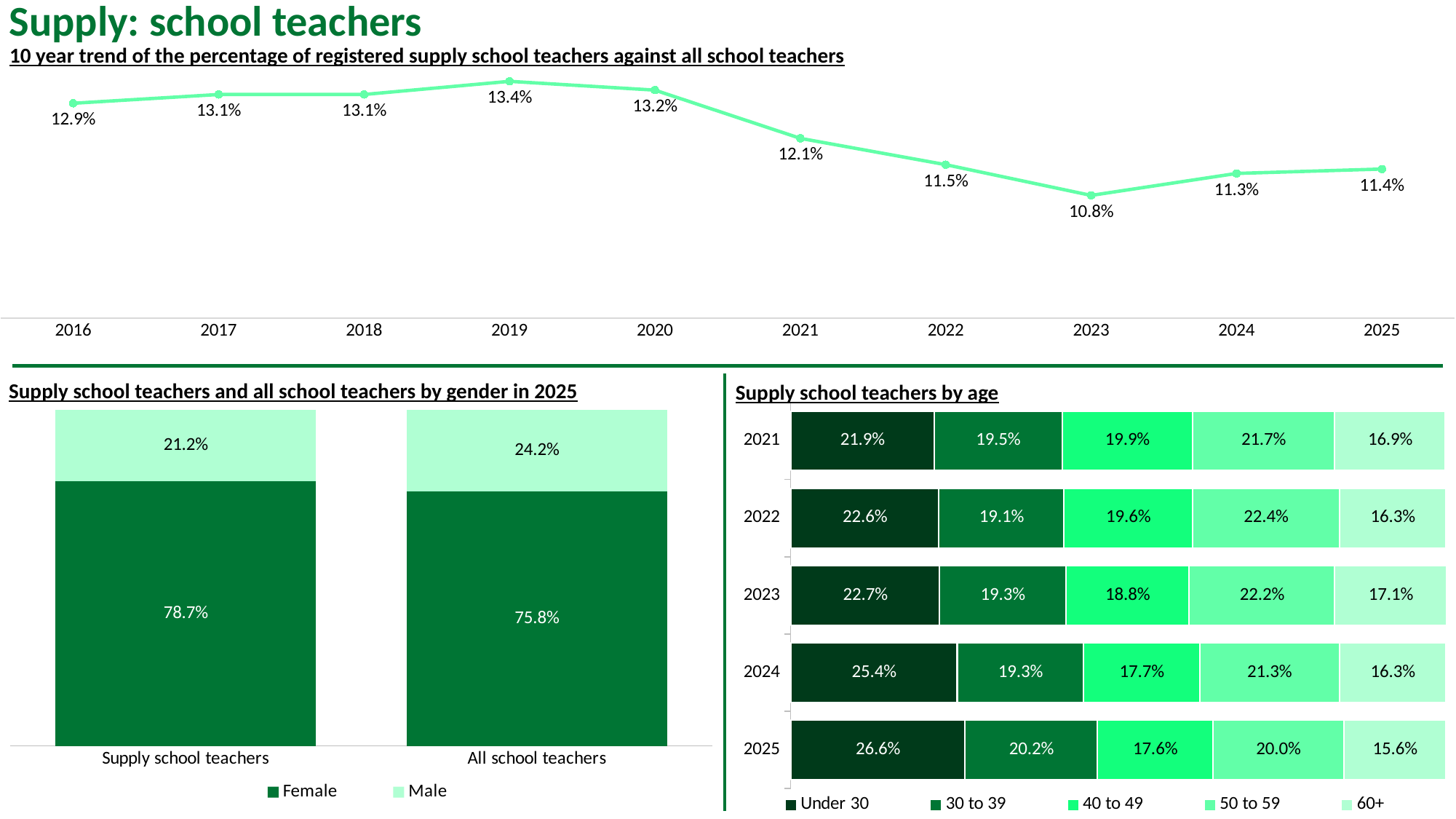
In the 'Supply school teachers and all school teachers by gender in 2025' chart, which group has the larger Male share, Supply school teachers or All school teachers? All school teachers In the '10 year trend' line chart, what is the difference between the 2016 value and the 2025 value? 1.5% In the '10 year trend of the percentage of registered supply school teachers against all school teachers' chart, what is the value for 2019? 13.4% In the '10 year trend' line chart, do the values rise or fall between 2020 and 2023? fall In the 'Supply school teachers and all school teachers by gender in 2025' chart, what kind of chart is it? stacked bar chart In the 'Supply school teachers by age' chart, what is the difference between the Under 30 value in 2024 and in 2021? 3.5% In the '10 year trend' line chart, which year has the highest value? 2019 In the '10 year trend' line chart, how many years are plotted? 10 In the 'Supply school teachers by age' chart, what is the Under 30 value for 2025? 26.6% In the '10 year trend' line chart, which year has the lowest value? 2023 In the 'Supply school teachers by age' chart, how many age groups does the legend list? 5 In the 'Supply school teachers and all school teachers by gender in 2025' chart, what is the Female share for Supply school teachers? 78.7%